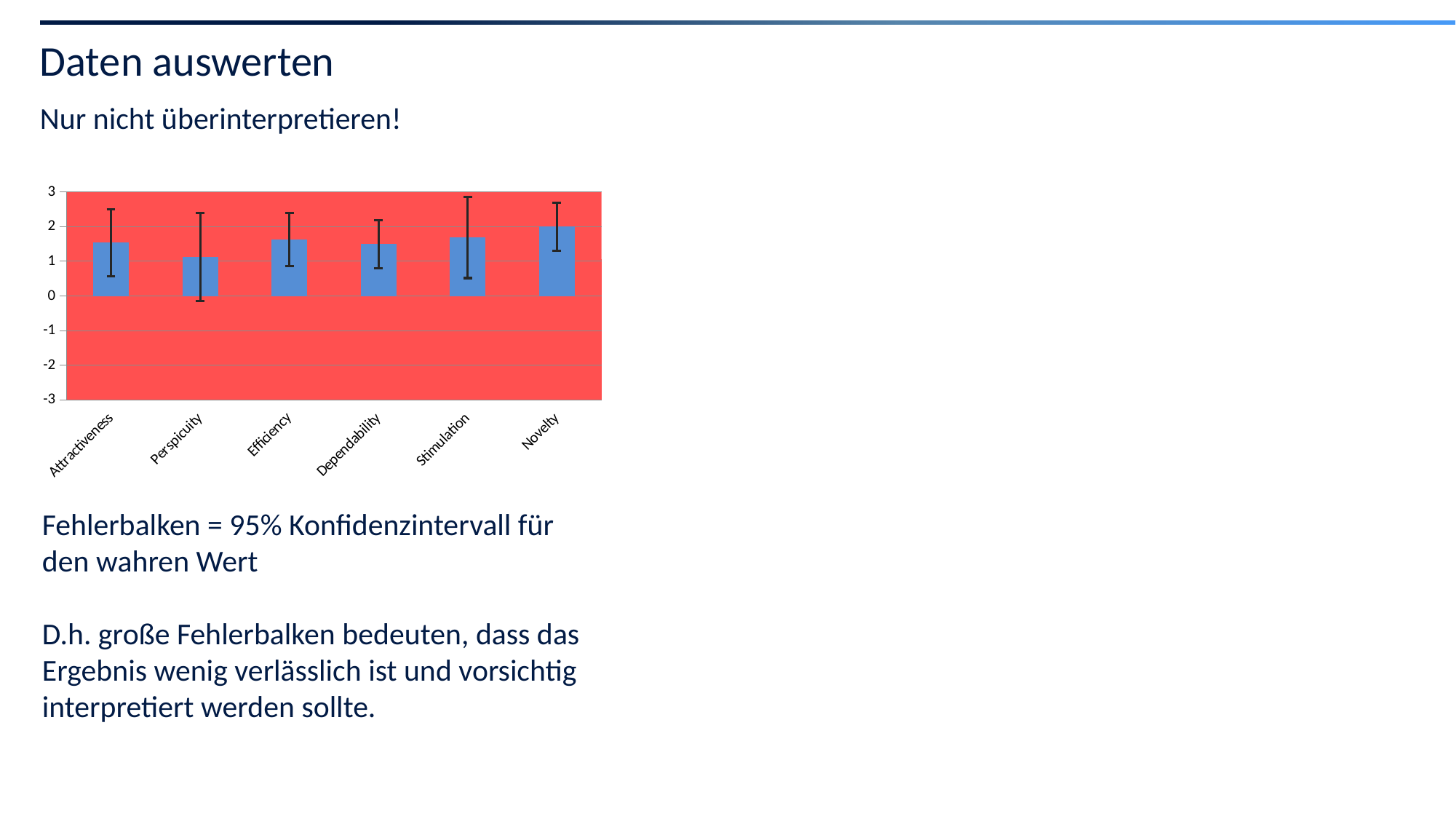
Is the value for Novelty greater or less than 1? greater What colour is the plot area background of the chart? red Is the value for Perspicuity greater or less than 2? less Which category has the highest bar in the chart? Novelty What is the highest tick value shown on the y axis of the chart? 3 Is the value for Stimulation greater or less than 2? less Which category has the lowest bar in the chart? Perspicuity How many categories are shown on the x axis of the chart? 6 Which is larger, the value for Stimulation or the value for Perspicuity? Stimulation What kind of chart is shown on the slide? bar chart Which is larger, the value for Novelty or the value for Perspicuity? Novelty